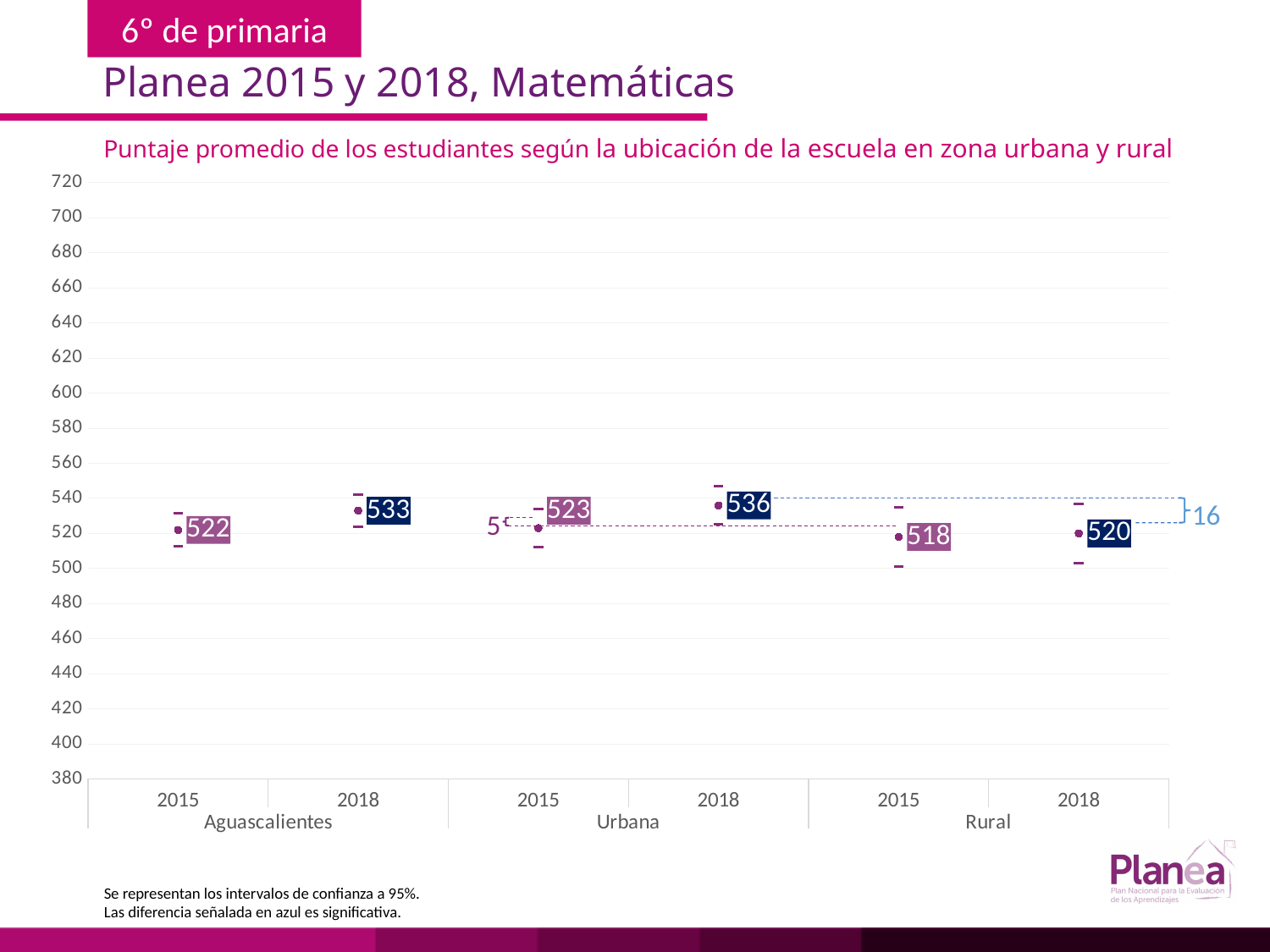
What is the average score for Rural schools in 2018? 520 What is the average score for Aguascalientes in 2015? 522 What is the average score for Rural schools in 2015? 518 Which is larger, the Urbana score in 2015 or the Rural score in 2015? Urbana 2015 What is the difference between the Aguascalientes scores in 2018 and 2015? 11 What is the average score for Aguascalientes in 2018? 533 Did the Rural score rise or fall from 2015 to 2018? rise Which category and year has the highest average score? Urbana 2018 What is the difference between the Urbana and Rural scores in 2018? 16 Which category and year has the lowest average score? Rural 2015 What is the average score for Urbana schools in 2018? 536